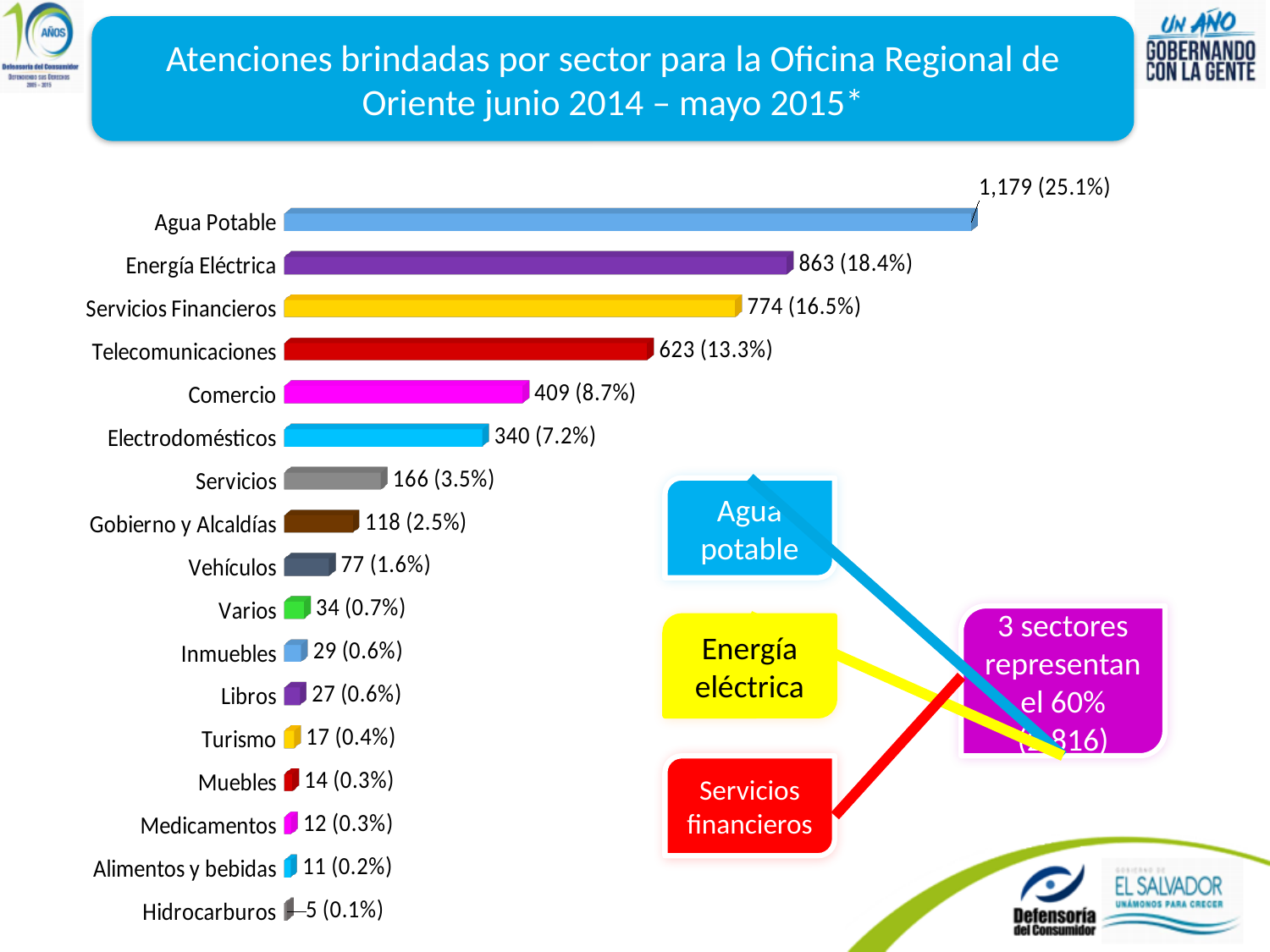
Which sector has the highest number of atenciones? Agua Potable What is the value shown for Hidrocarburos? 5 (0.1%) What is the value shown for Telecomunicaciones? 623 (13.3%) What type of chart is shown on the slide? Bar chart Which is larger, the value for Comercio or the value for Electrodomésticos? Comercio What percentage is shown for Electrodomésticos? 7.2% What is the difference between the values for Servicios and Gobierno y Alcaldías? 48 Which sector has the lowest number of atenciones? Hidrocarburos What is the value shown for Agua Potable? 1,179 (25.1%) According to the callout box on the slide, what share do the top 3 sectors represent? 60% How many sectors (categories) are plotted in the chart? 17 What is the difference between the values for Energía Eléctrica and Servicios Financieros? 89